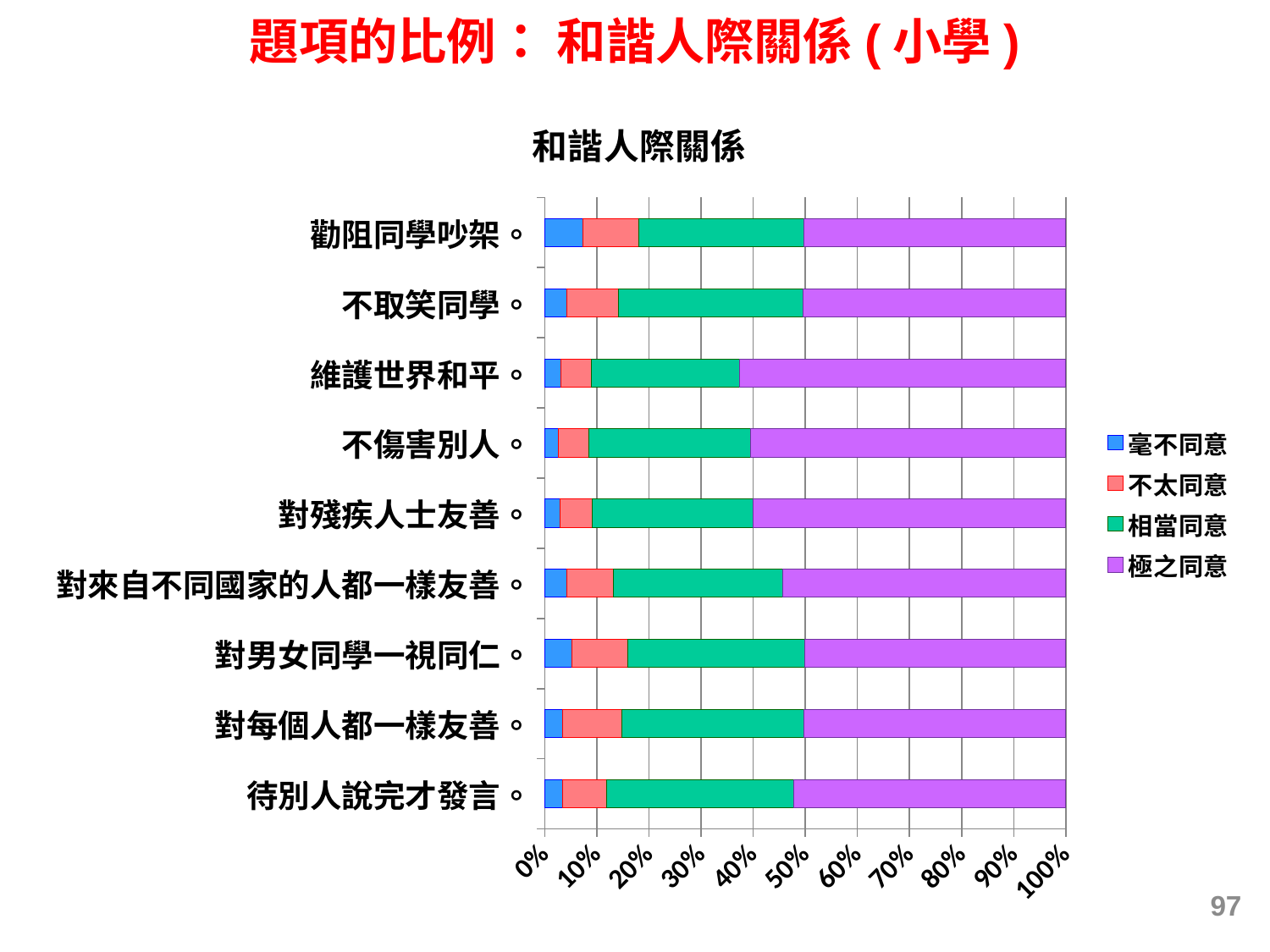
Is the 極之同意 value for 維護世界和平 greater or less than 50%? greater How many categories (items) are plotted on the chart? 9 Which series is shown in purple in the legend? 極之同意 How many series does the legend list? 4 Is the 極之同意 value for 不傷害別人 greater or less than 50%? greater Is the 相當同意 value for 對男女同學一視同仁 greater or less than 30%? greater What kind of chart is shown on the slide? Stacked bar chart What is the title of the chart? 和諧人際關係 Which has the larger 毫不同意 value: 勸阻同學吵架 or 不傷害別人? 勸阻同學吵架 Which category has the largest 毫不同意 segment? 勸阻同學吵架 Which has the larger 極之同意 value: 不傷害別人 or 對男女同學一視同仁? 不傷害別人